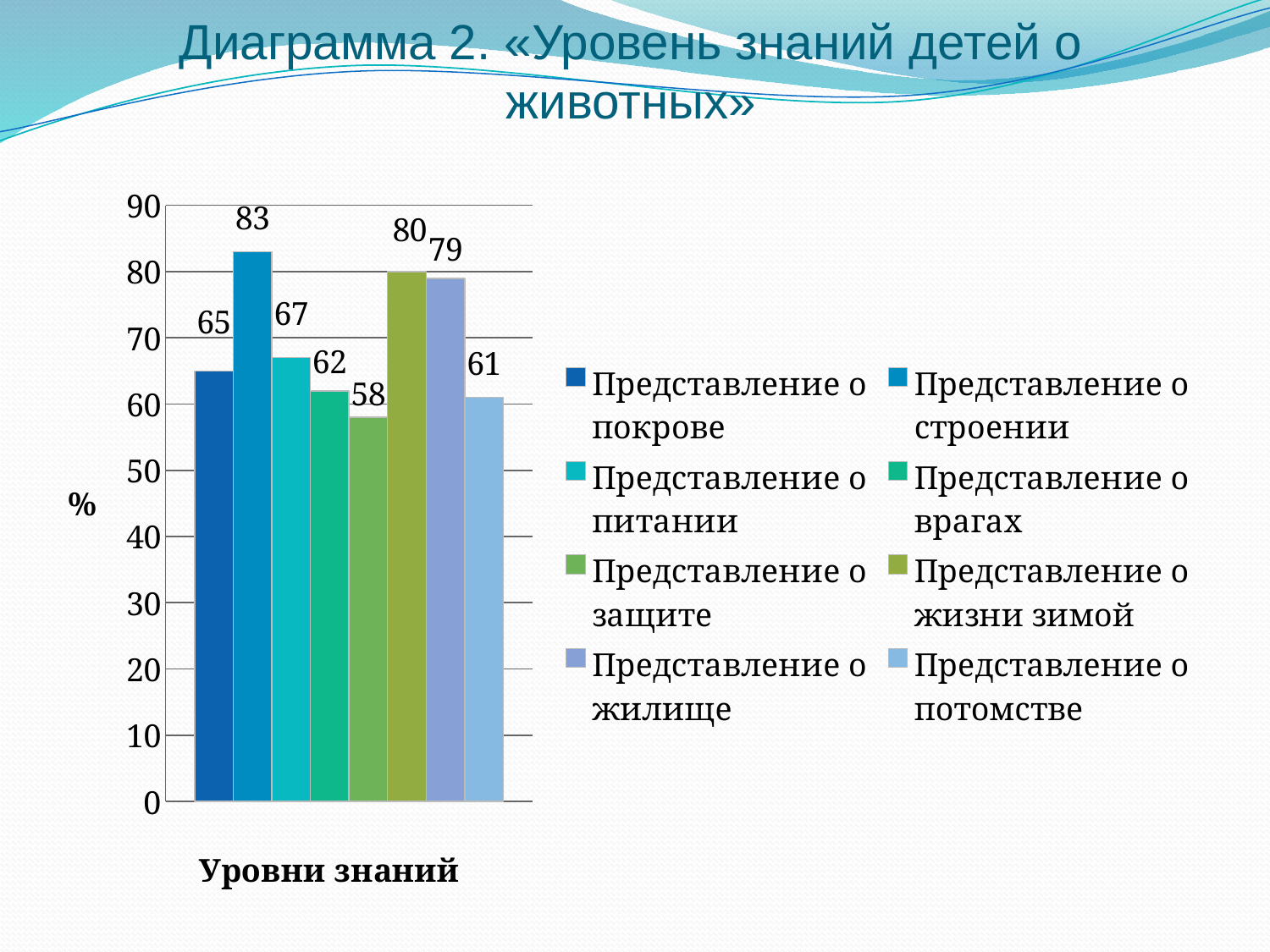
What kind of chart is shown on the slide? bar chart Which is larger: the value for «Представление о покрове» or «Представление о питании»? Представление о питании Which series has the highest value? Представление о строении What is the value for «Представление о потомстве»? 61 What is the value for «Представление о строении»? 83 What is the value for «Представление о защите»? 58 What is the difference between the values for «Представление о строении» and «Представление о защите»? 25 What is the value for «Представление о жизни зимой»? 80 How many series does the legend list? 8 What is the label on the vertical axis? % Which series has the lowest value? Представление о защите Is the value for «Представление о жилище» greater or less than 70? greater